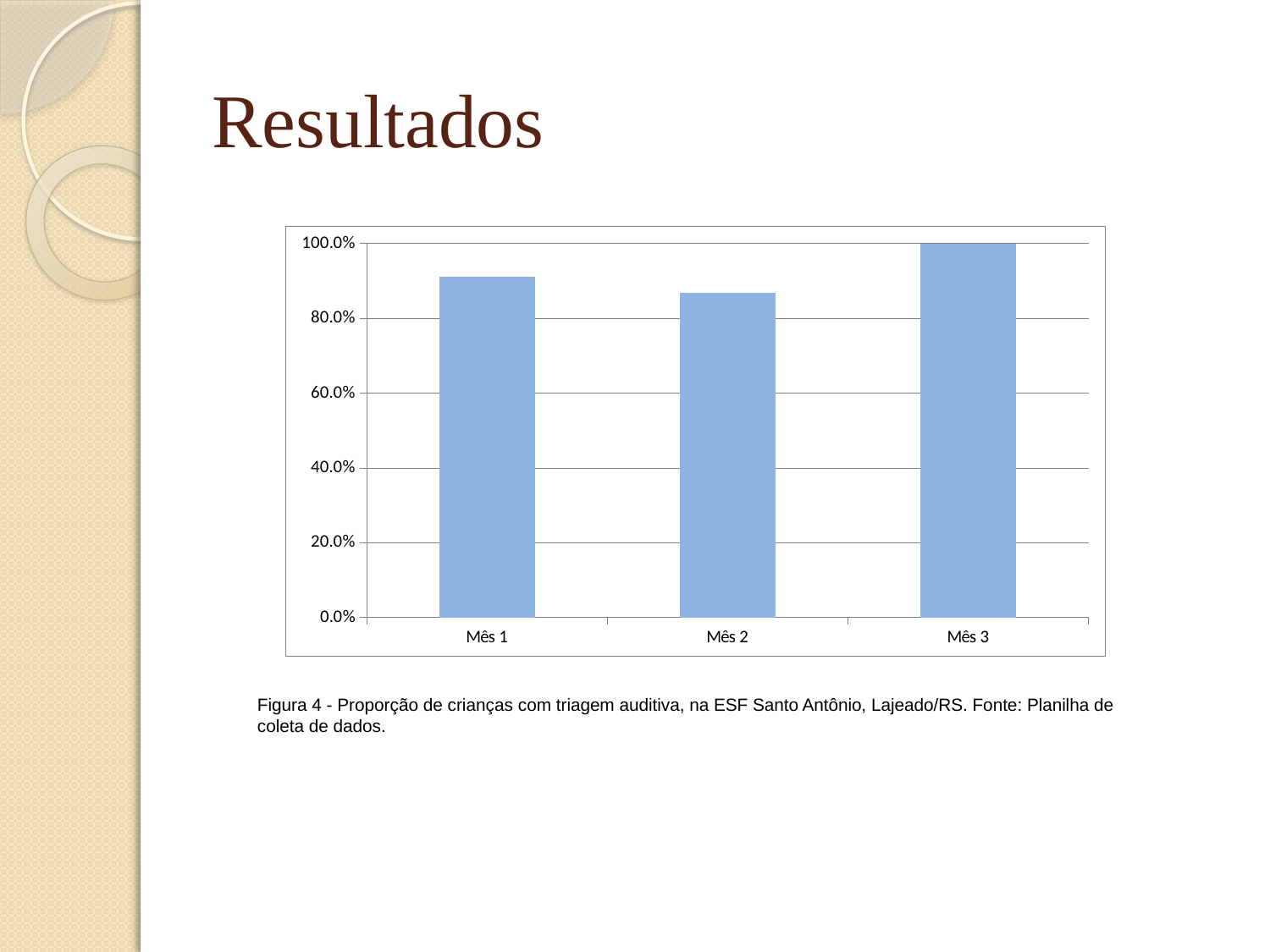
What kind of chart is shown on the slide? Bar chart Is the value for Mês 1 greater or less than 80.0%? greater Is the value for Mês 2 greater or less than 80.0%? greater Is the value for Mês 1 greater or less than 100.0%? less How many categories (months) are shown on the x axis of the chart? 3 Which month has the lowest value in the chart? Mês 2 What is the highest value shown on the y axis of the chart? 100.0% Does the value rise or fall from Mês 2 to Mês 3? rises What is the value for Mês 3 in the chart? 100.0% Which month has the highest value in the chart? Mês 3 According to the caption, what figure number is this chart? Figura 4 Which is larger, the value for Mês 1 or the value for Mês 2? Mês 1